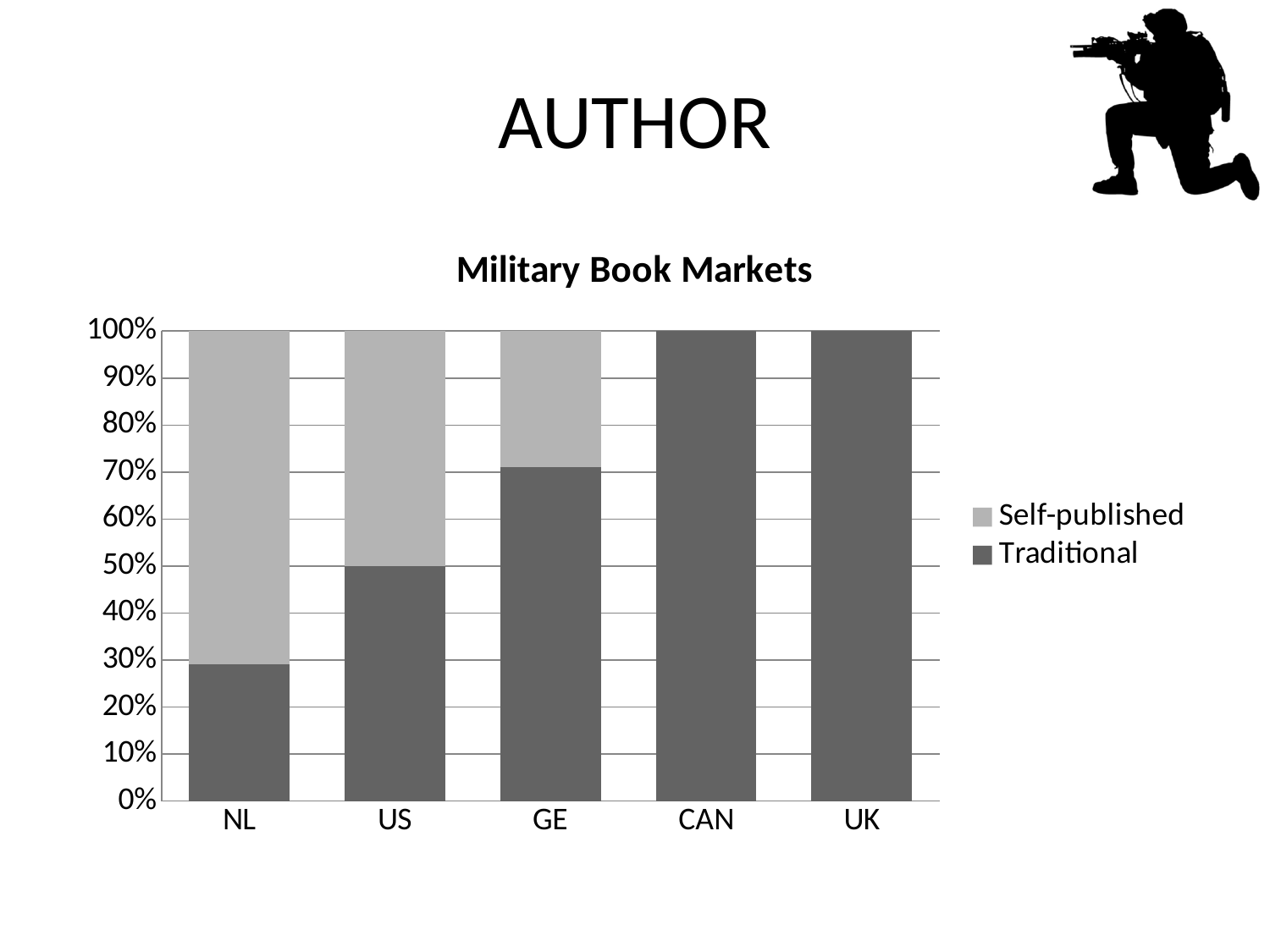
What is the Traditional value for CAN? 100% How many categories are shown on the x axis? 5 Which series is shown in the lighter grey colour? Self-published Is the Traditional value for GE greater or less than 60%? greater What type of chart is shown on the slide? bar chart Is the Self-published value for NL greater or less than 60%? greater Which is larger, the Self-published share for US or for GE? US Is the Traditional value for NL greater or less than 40%? less What is the title of the chart? Military Book Markets Which category has the lowest Traditional share? NL How many series does the legend list? 2 What is the Traditional value for US? 50%